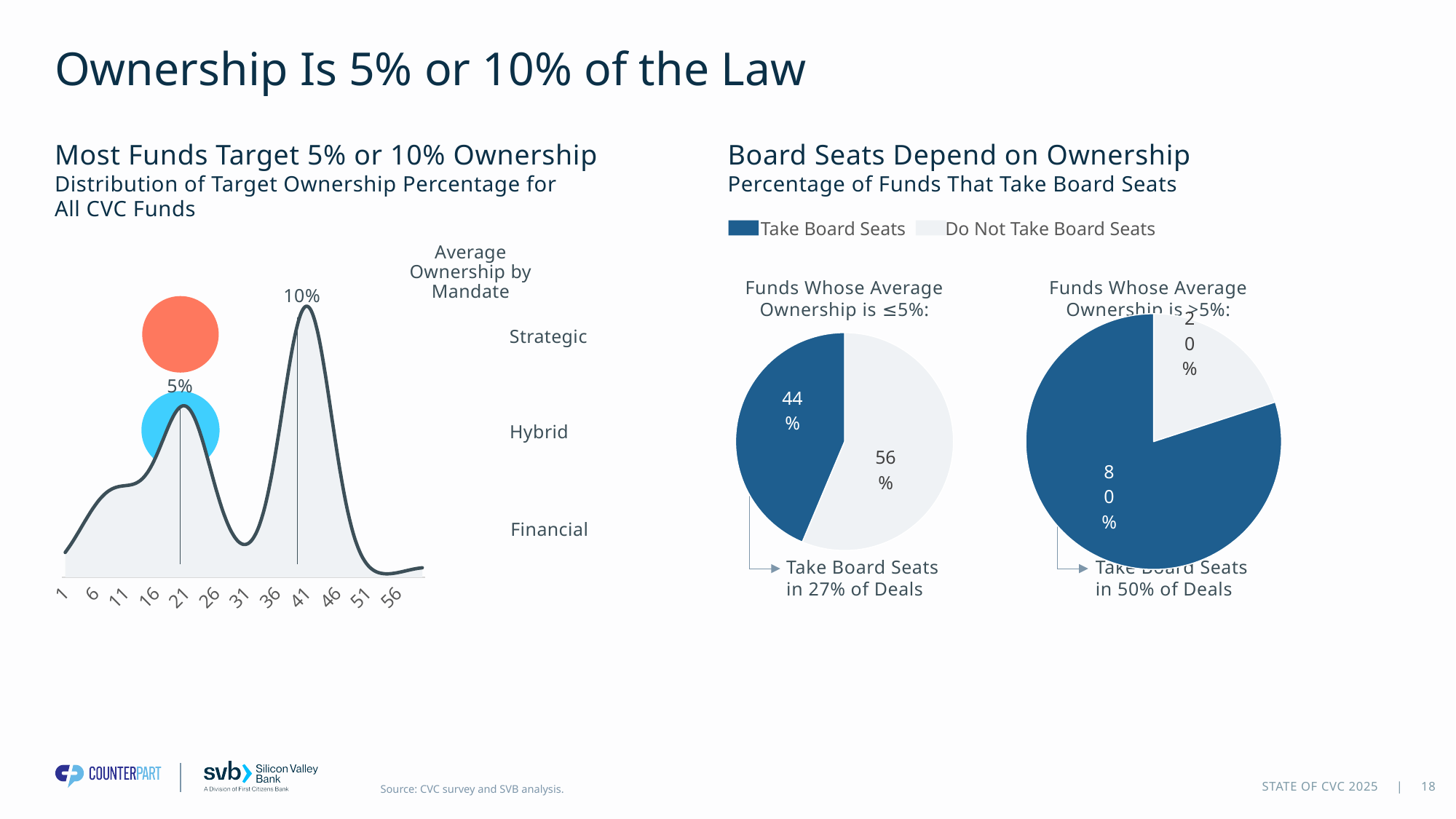
In the pie chart for Funds Whose Average Ownership is >5%, what share of funds Take Board Seats? 80% What is the difference in the Take Board Seats share between the >5% ownership pie chart and the ≤5% ownership pie chart? 36 percentage points What kind of charts are used under Board Seats Depend on Ownership? Pie charts How many tick labels are shown on the x axis of the Distribution of Target Ownership Percentage chart on the left? 12 In the pie chart for Funds Whose Average Ownership is >5%, what is the difference between the Take Board Seats and Do Not Take Board Seats slices? 60 percentage points How many series does the legend of the Board Seats Depend on Ownership charts list? 2 In the pie chart for Funds Whose Average Ownership is ≤5%, which slice is larger: Take Board Seats or Do Not Take Board Seats? Do Not Take Board Seats In the Distribution of Target Ownership Percentage chart on the left, which labeled peak is higher: 5% or 10%? 10% According to the annotation under the ≤5% ownership pie chart, in what percentage of deals do these funds take board seats? 27% In the pie chart for Funds Whose Average Ownership is ≤5%, what share of funds Do Not Take Board Seats? 56% In the pie chart for Funds Whose Average Ownership is ≤5%, what share of funds Take Board Seats? 44%